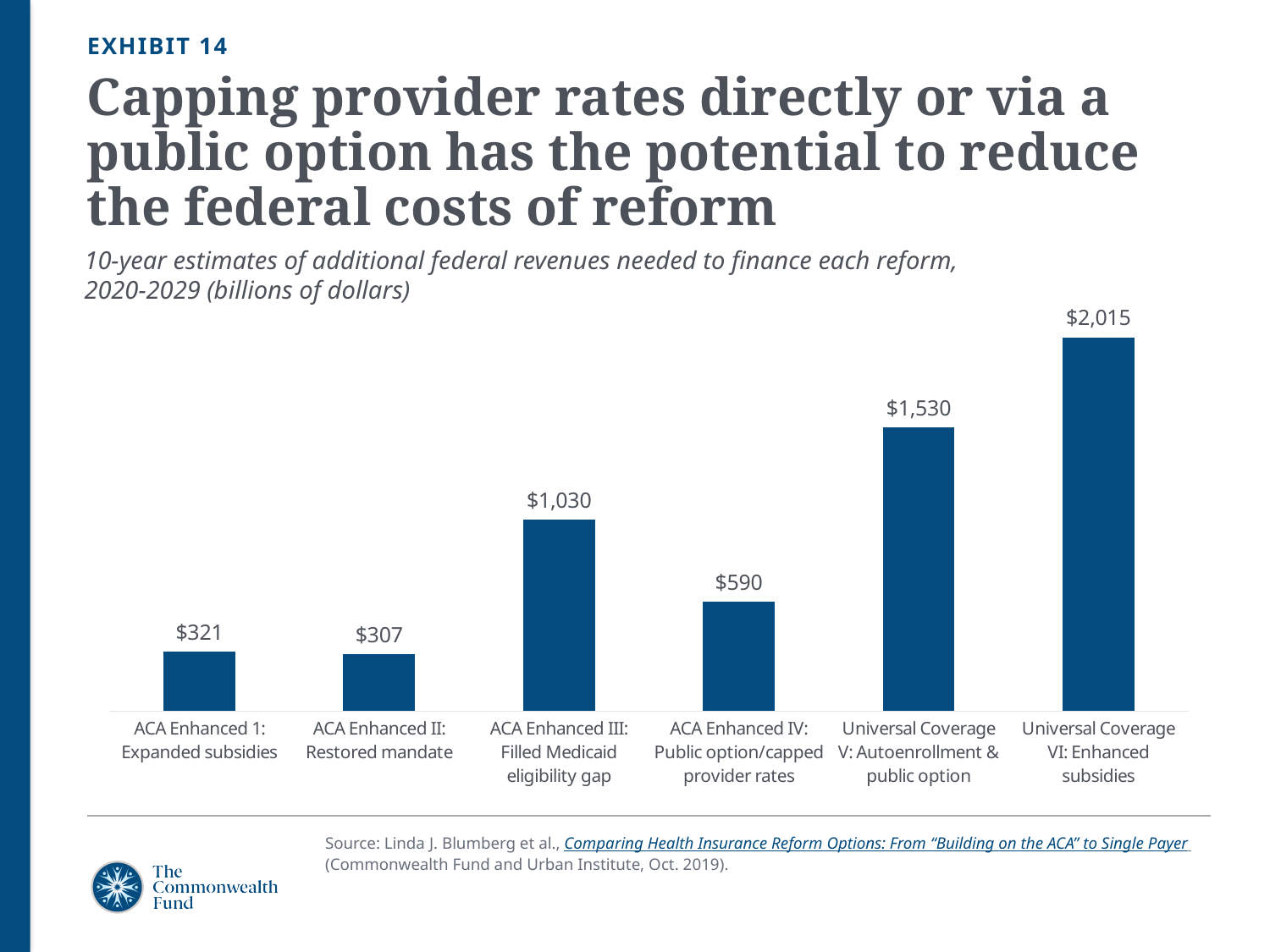
What is the value for ACA Enhanced IV: Public option/capped provider rates? $590 Which is larger, the value for ACA Enhanced 1: Expanded subsidies or ACA Enhanced II: Restored mandate? ACA Enhanced 1: Expanded subsidies How many reform options are shown in the chart? 6 What unit are the values in the chart expressed in? Billions of dollars What is the value for Universal Coverage V: Autoenrollment & public option? $1,530 What time period do the estimates in the chart cover? 2020-2029 What kind of chart is shown on the slide? Bar chart Which reform requires the least additional federal revenue? ACA Enhanced II: Restored mandate Which reform requires the most additional federal revenue? Universal Coverage VI: Enhanced subsidies What is the difference between the values for Universal Coverage VI: Enhanced subsidies and Universal Coverage V: Autoenrollment & public option? $485 What is the difference between the values for ACA Enhanced III: Filled Medicaid eligibility gap and ACA Enhanced IV: Public option/capped provider rates? $440 What is the value for ACA Enhanced III: Filled Medicaid eligibility gap? $1,030